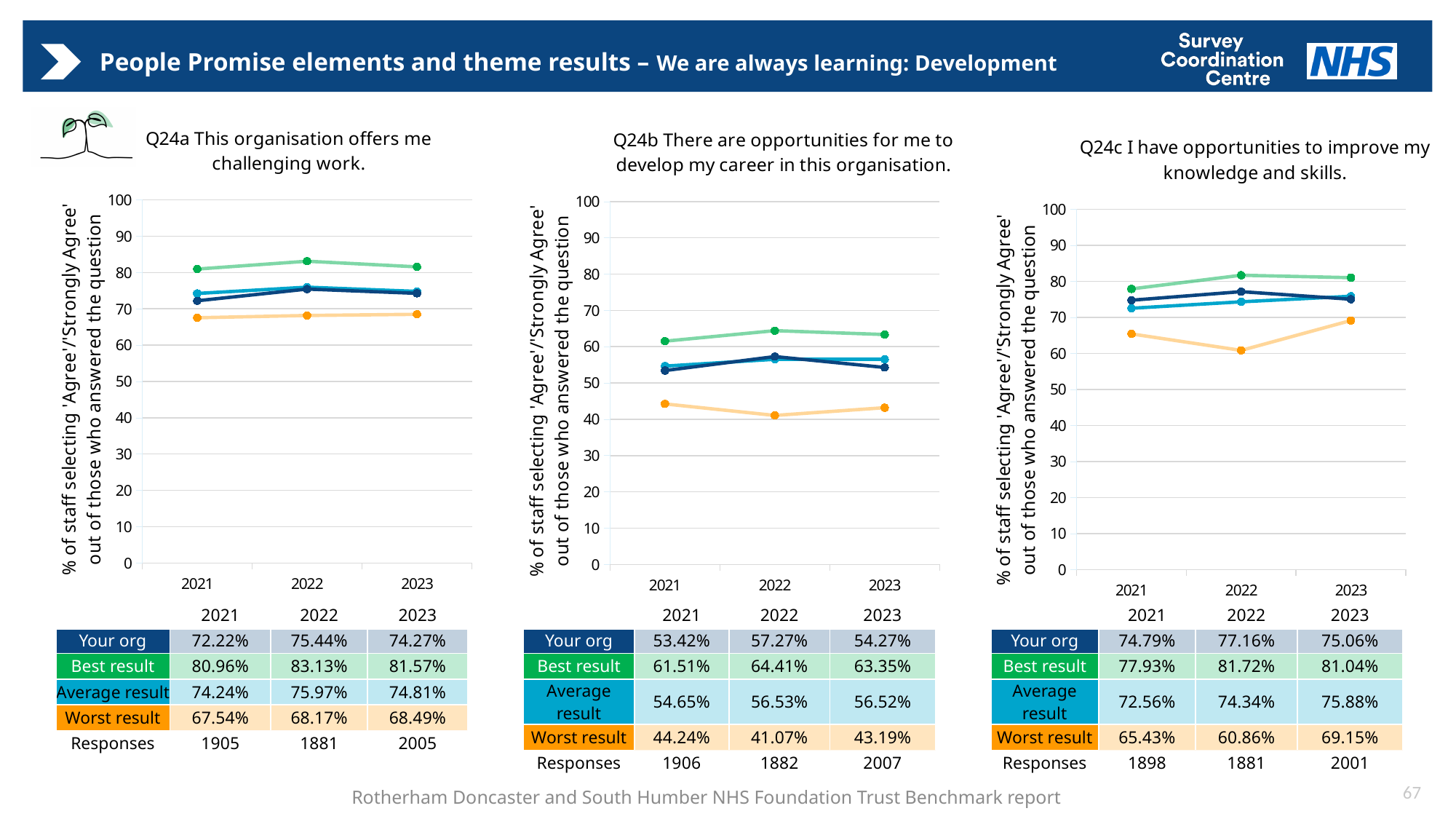
In the Q24b chart (opportunities to develop my career), what was the 'Worst result' value in 2022? 41.07% In the Q24b chart, is the 'Your org' value for 2021 greater or less than 60? less In the Q24a chart, which year had the highest 'Best result' value? 2022 In the Q24c chart (opportunities to improve my knowledge and skills), what was the 'Best result' value in 2023? 81.04% What type of chart is used for Q24c? Line chart In the Q24c chart, which year had the lowest 'Worst result' value? 2022 In the Q24c chart, which was larger in 2021: 'Your org' or 'Average result'? Your org In the Q24b chart, how many responses were recorded in 2023? 2007 In the Q24a chart (This organisation offers me challenging work), what was the 'Your org' value in 2022? 75.44% In the Q24b chart, what is the difference between the 'Best result' and 'Your org' values in 2023? 9.08% How many years are plotted on the x axis of the Q24a chart? 3 How many series are plotted in the Q24b chart? 4